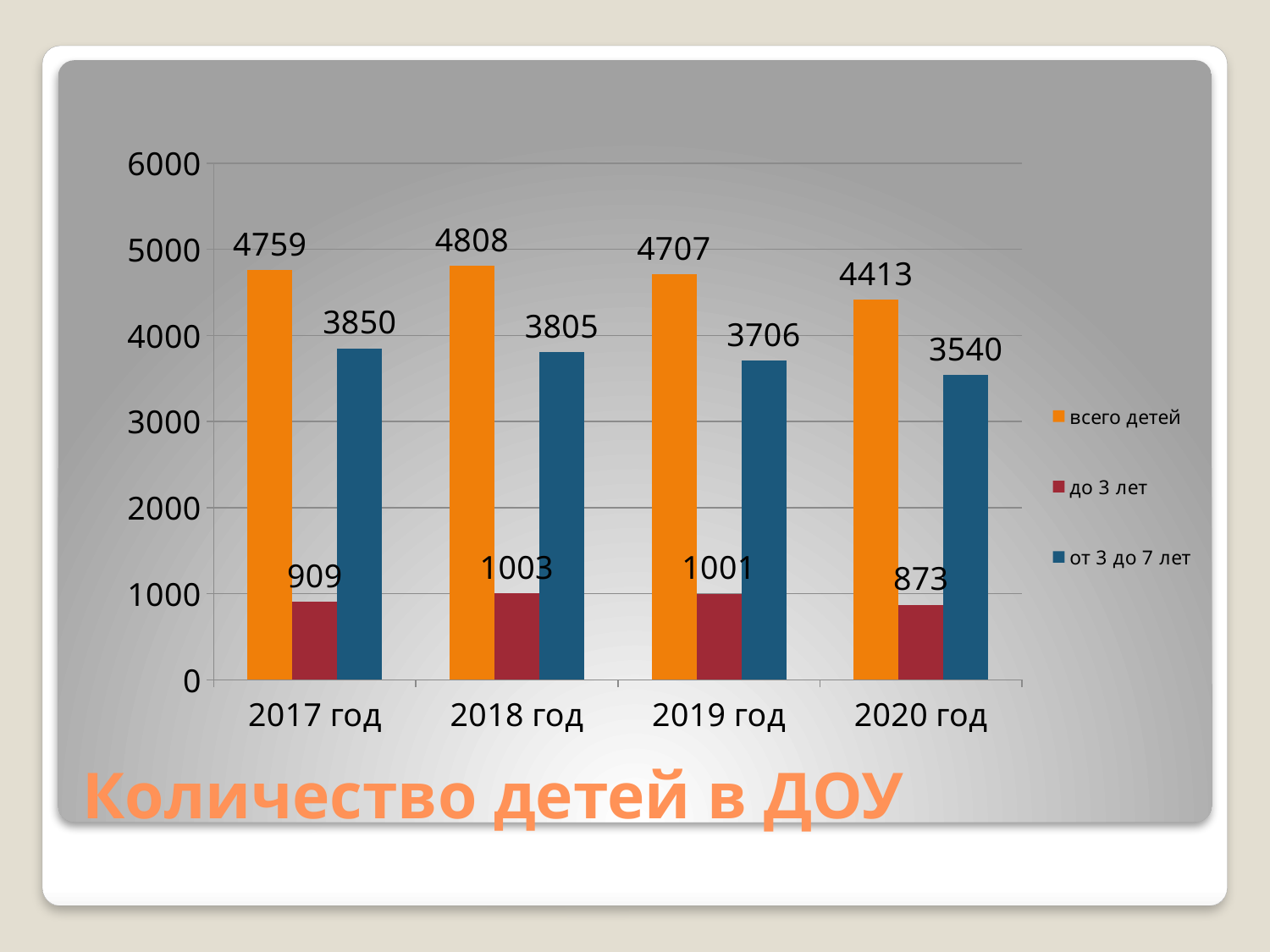
Does the value for "от 3 до 7 лет" rise or fall from 2017 год to 2020 год? fall How many series does the legend list? 3 Which is larger: the "до 3 лет" value for 2018 год or for 2019 год? 2018 год How many years are shown on the x axis? 4 What is the value for "от 3 до 7 лет" in 2019 год? 3706 Is the value for "от 3 до 7 лет" in 2017 год greater or less than 4000? less What is the value for "всего детей" in 2018 год? 4808 What is the value for "до 3 лет" in 2020 год? 873 What is the difference between the "всего детей" values for 2017 год and 2020 год? 346 What kind of chart is shown on the slide? bar chart In which year is the value for "всего детей" highest? 2018 год In which year is the value for "от 3 до 7 лет" lowest? 2020 год